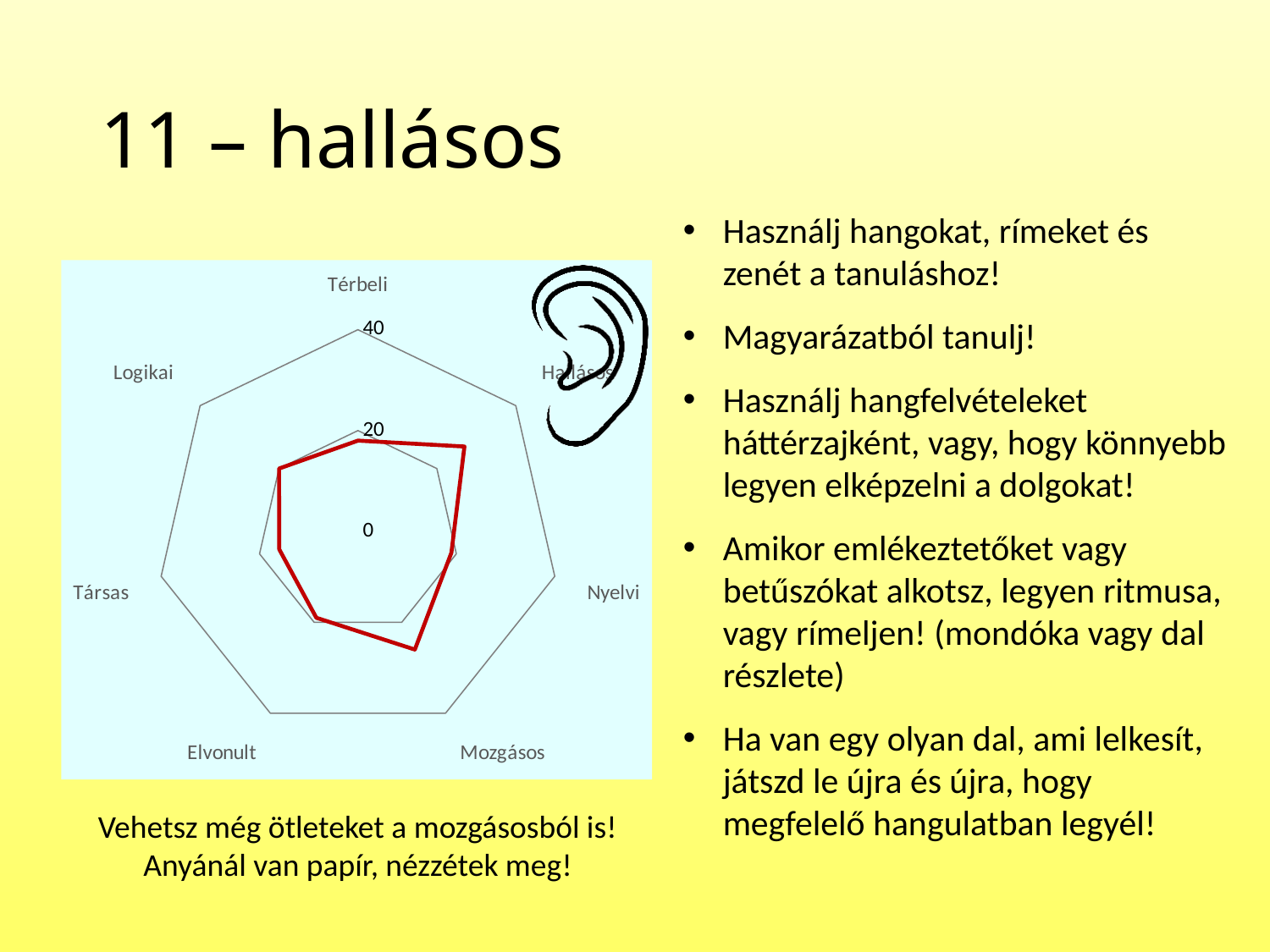
Which is larger, the value for Hallásos or the value for Térbeli? Hallásos Which is larger, the value for Mozgásos or the value for Társas? Mozgásos Is the value for Hallásos greater or less than 20? greater Is the value for Hallásos greater or less than 40? less Which category is labelled at the top of the radar chart? Térbeli How many categories (axes) does the radar chart have? 7 What is the highest value shown on the chart's axis scale? 40 How many data series are plotted on the radar chart? 1 Is the value for Mozgásos greater or less than 20? greater What kind of chart is shown on the slide? radar chart